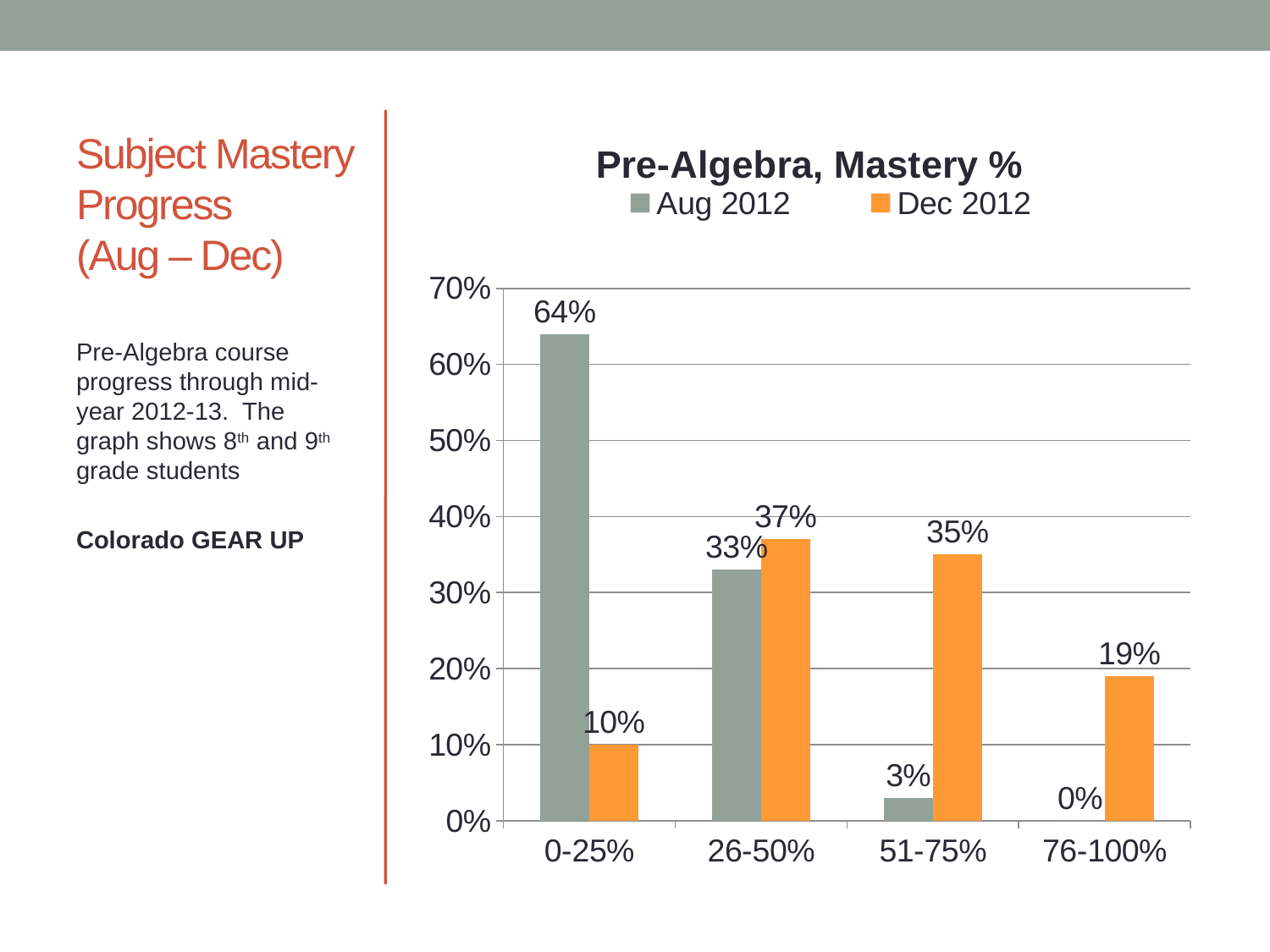
Which is larger for the 26-50% category, the Aug 2012 value or the Dec 2012 value? Dec 2012 What is the Aug 2012 value for the 76-100% category? 0% What is the Dec 2012 value for the 76-100% category? 19% Which category has the lowest Dec 2012 value? 0-25% What is the Dec 2012 value for the 51-75% category? 35% How many series does the legend list? 2 What is the difference between the Aug 2012 and Dec 2012 values for the 0-25% category? 54% What is the Aug 2012 value for the 0-25% category? 64% Which category has the highest Aug 2012 value? 0-25% What kind of chart is shown on the slide? Bar chart How many categories are shown on the x axis? 4 What is the title of the chart? Pre-Algebra, Mastery %